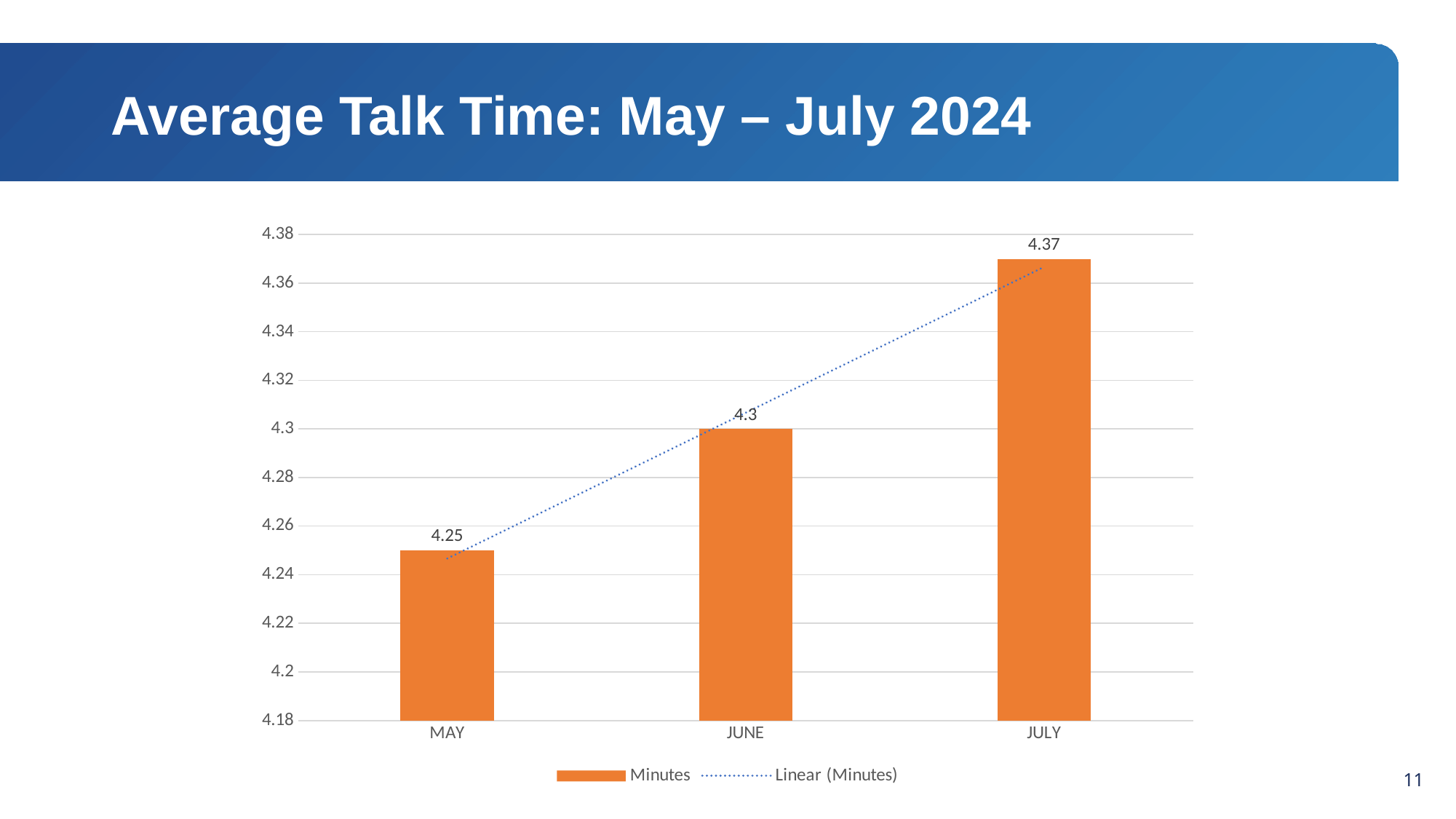
What kind of chart is shown on the slide? bar chart Which month has the lowest average talk time? MAY Which month has the highest average talk time? JULY Do the values rise or fall from MAY to JULY? rise Is the value for MAY greater or less than 4.3? less What is the value for JULY? 4.37 What is the difference between the values for JULY and MAY? 0.12 What is the value for MAY? 4.25 What is the value for JUNE? 4.3 Which is larger, the value for JUNE or the value for JULY? JULY How many months are shown on the x axis? 3 What is the difference between the values for JUNE and MAY? 0.05